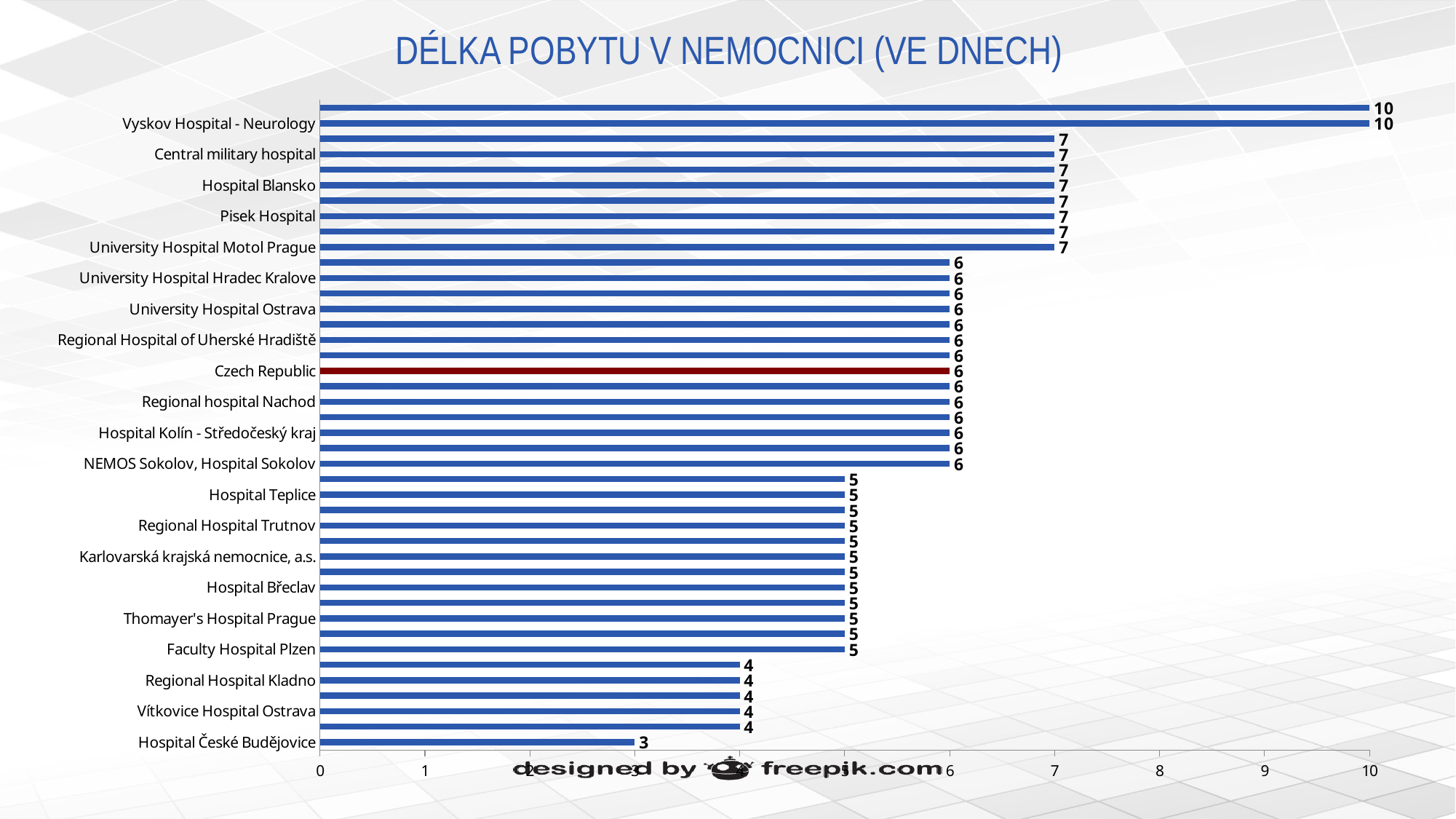
What value is shown for Czech Republic? 6 What is the difference between the values for Vyskov Hospital - Neurology and Hospital České Budějovice? 7 What is the length of stay in days for Vyskov Hospital - Neurology? 10 What kind of chart is shown on the slide? bar chart Which is larger, the value for Central military hospital or the value for Faculty Hospital Plzen? Central military hospital Which category's bar is coloured dark red instead of blue? Czech Republic Which category has the lowest value on the chart? Hospital České Budějovice What is the value for Hospital České Budějovice? 3 What is the value for Hospital Teplice? 5 What value is shown for Regional Hospital Kladno? 4 Is the value for Hospital Blansko greater or less than 5? greater What is the highest value shown on the chart? 10